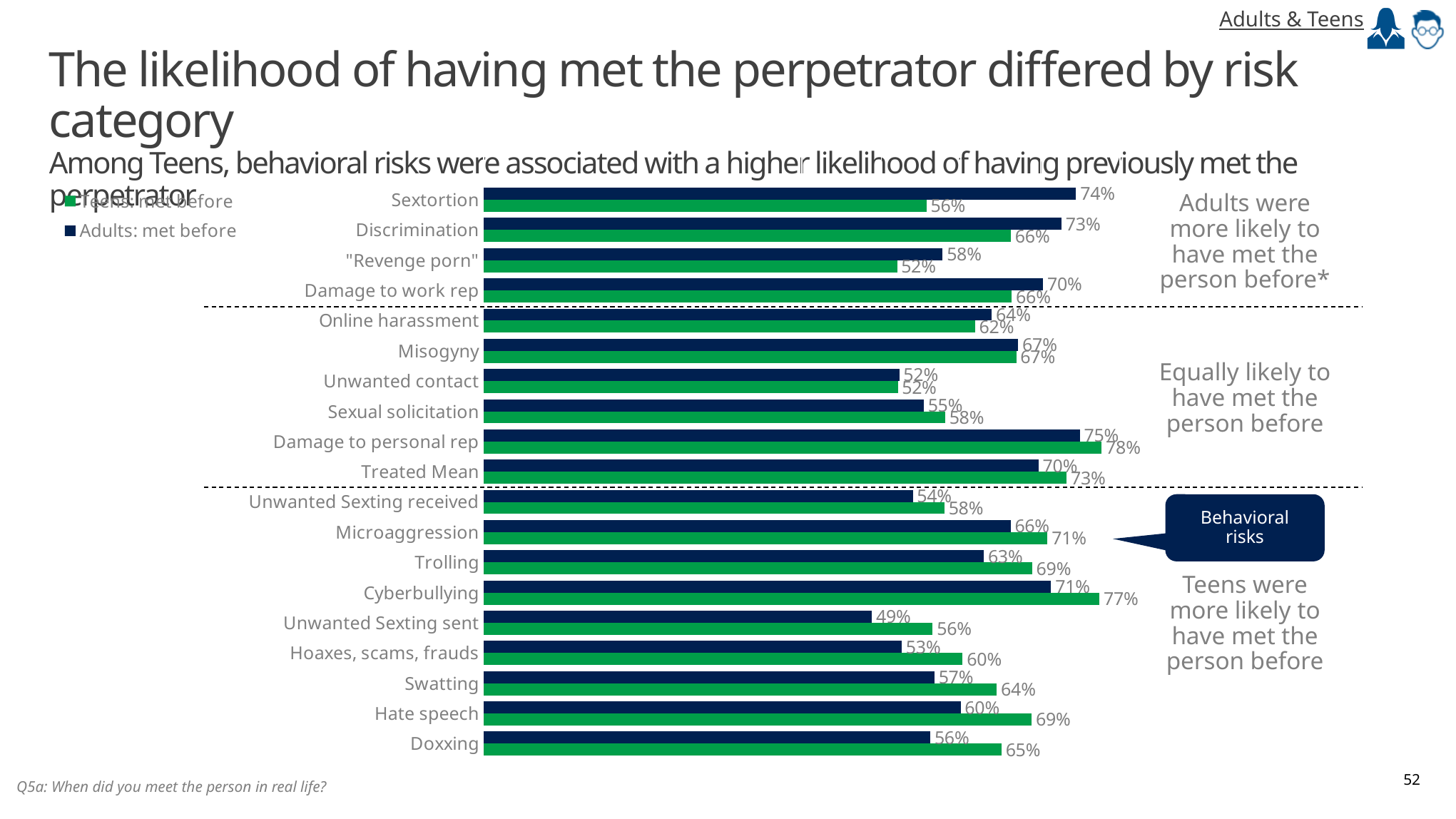
What is the teens value for Cyberbullying? 77% What is the difference between the teens and adults values for Hate speech? 9% Which risk category has the highest teens value? Damage to personal rep What percentage of adults had met the perpetrator before for Sextortion? 74% For Discrimination, which is larger: the adults value or the teens value? Adults How many series does the legend list? 2 What is the adults value for Unwanted Sexting sent? 49% For Trolling, which is larger: the adults value or the teens value? Teens What type of chart is shown on the slide? Bar chart What is the difference between the adults and teens values for Sextortion? 18% How many risk categories are shown in the chart? 19 Which risk category has the lowest adults value? Unwanted Sexting sent